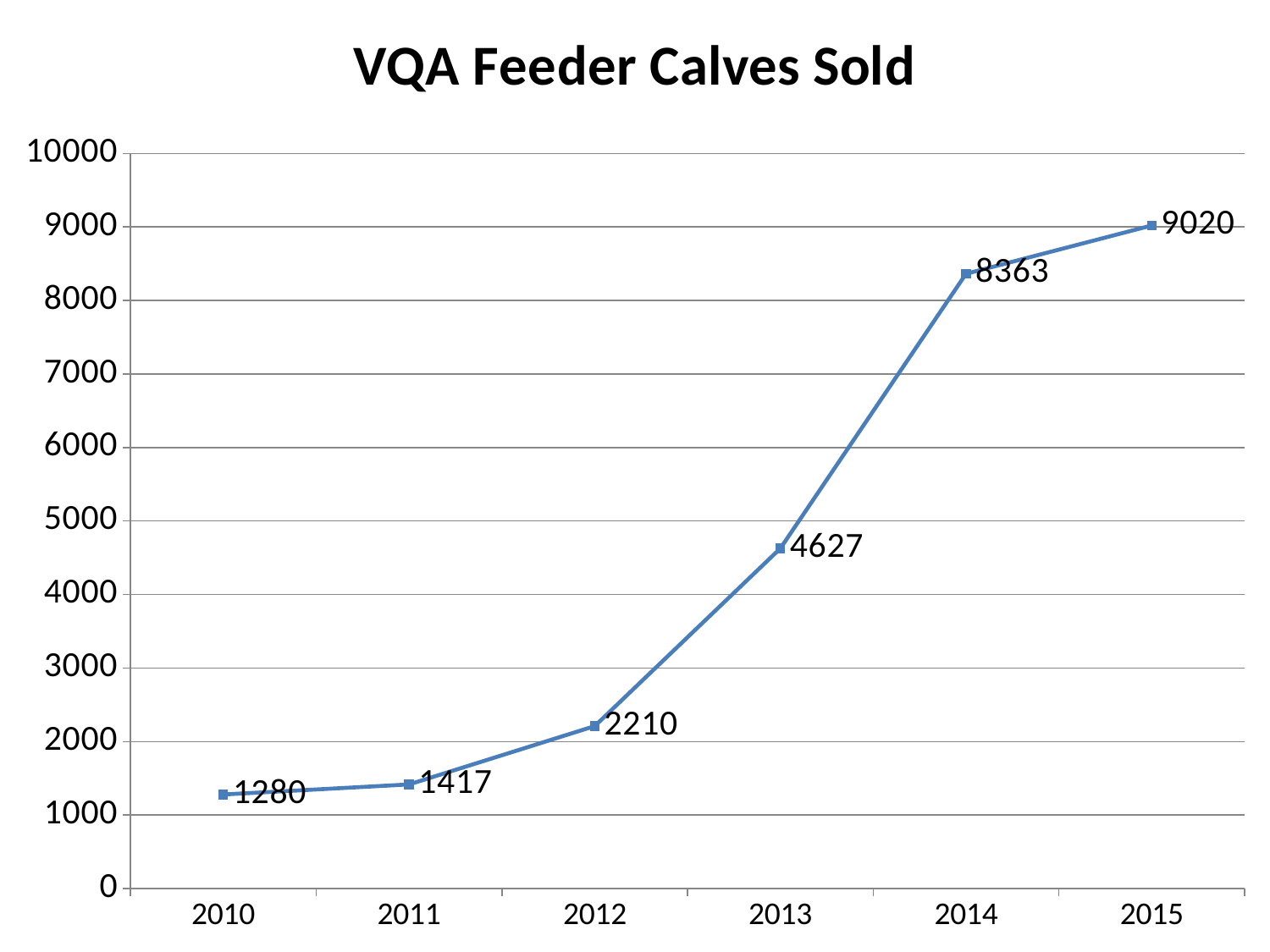
Which year has the lowest value? 2010 What is the value for 2010? 1280 What is the value for 2013? 4627 What kind of chart is this? line chart Do the values rise or fall from 2010 to 2015? rise Is the value for 2014 greater or less than 8000? greater What is the difference between the values for 2014 and 2013? 3736 How many years are plotted on the chart? 6 What is the value for 2015? 9020 Which year has the highest value? 2015 What is the difference between the values for 2011 and 2010? 137 Which is larger, the value for 2012 or the value for 2011? 2012